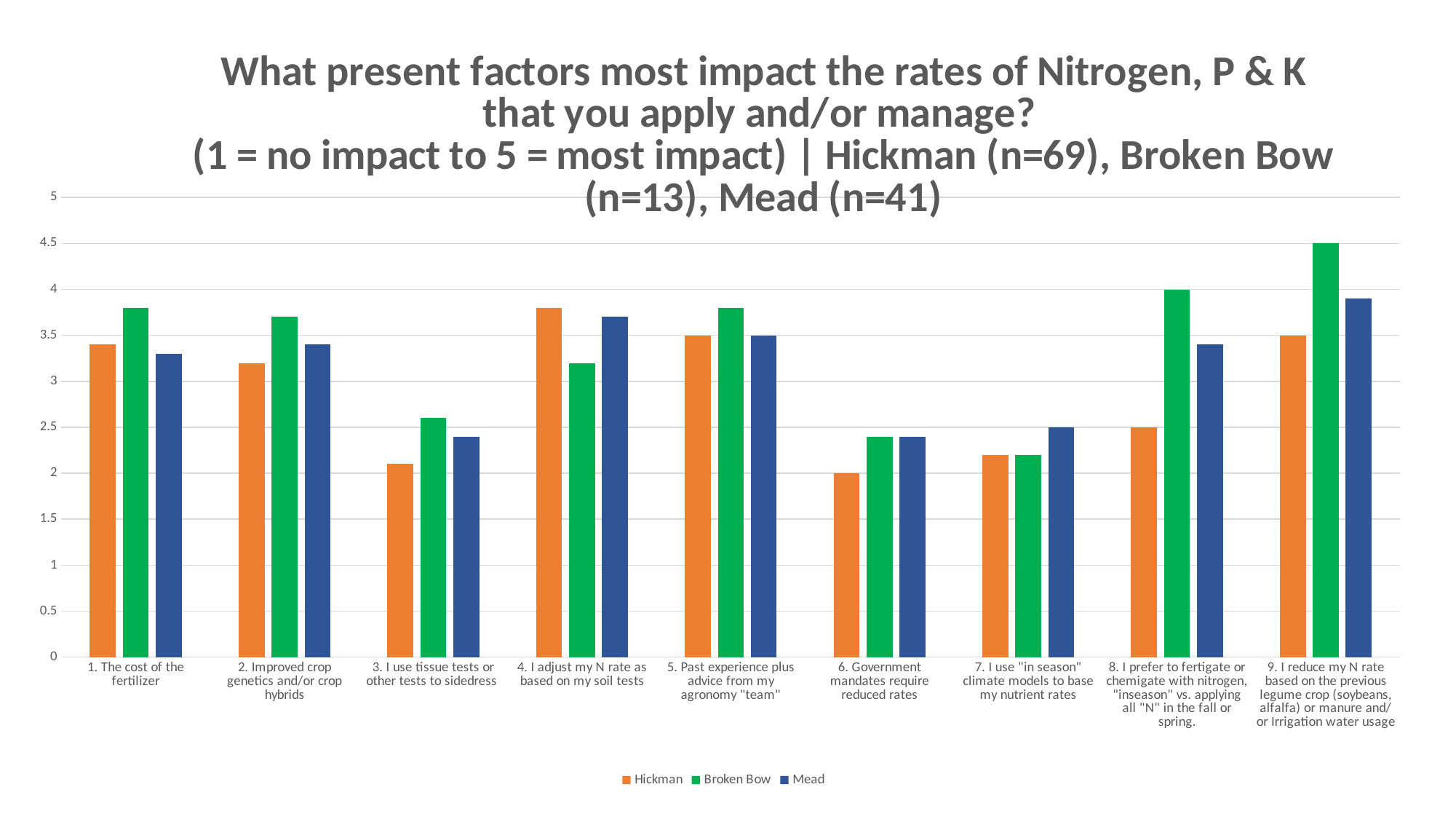
What is the Broken Bow value for "8. I prefer to fertigate or chemigate with nitrogen, 'inseason' vs. applying all 'N' in the fall or spring."? 4 What is the Broken Bow value for "9. I reduce my N rate based on the previous legume crop (soybeans, alfalfa) or manure and/or Irrigation water usage"? 4.5 What is the Hickman value for "6. Government mandates require reduced rates"? 2 What kind of chart is shown on the slide? Bar chart Which series is shown in green in the legend? Broken Bow Is the Hickman value for "3. I use tissue tests or other tests to sidedress" greater or less than 2.5? less Is the Mead value for "9. I reduce my N rate based on the previous legume crop (soybeans, alfalfa) or manure and/or Irrigation water usage" greater or less than 4? less For which factor does Hickman have its lowest value? 6. Government mandates require reduced rates For "4. I adjust my N rate as based on my soil tests", which is larger: the Hickman value or the Broken Bow value? Hickman How many factor categories are plotted along the x axis? 9 For which factor does Broken Bow have its highest value? 9. I reduce my N rate based on the previous legume crop (soybeans, alfalfa) or manure and/or Irrigation water usage How many series does the legend list? 3